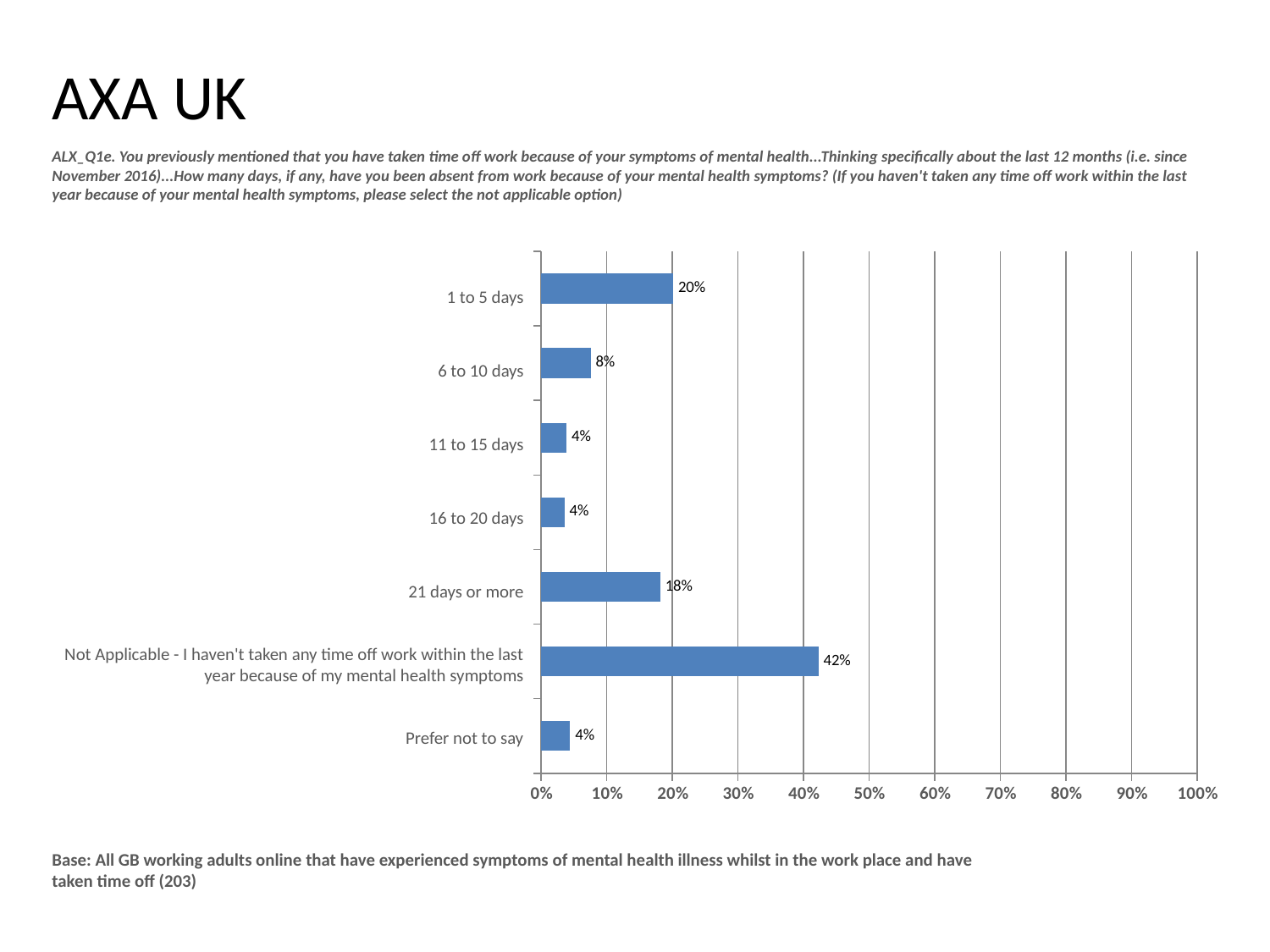
What is the value for '6 to 10 days'? 8% Which category has the highest value? Not Applicable - I haven't taken any time off work within the last year because of my mental health symptoms What percentage of respondents were absent for 1 to 5 days? 20% What kind of chart is shown on the slide? Bar chart What is the base size stated below the chart? 203 What percentage selected 'Prefer not to say'? 4% Which is larger, the value for '6 to 10 days' or the value for '11 to 15 days'? 6 to 10 days How many categories are shown on the chart? 7 Is the value for 'Not Applicable' greater or less than 40%? greater What is the difference between the 'Not Applicable' value and the '1 to 5 days' value? 22% What is the difference between the '1 to 5 days' value and the '21 days or more' value? 2% What is the value shown for '21 days or more'? 18%